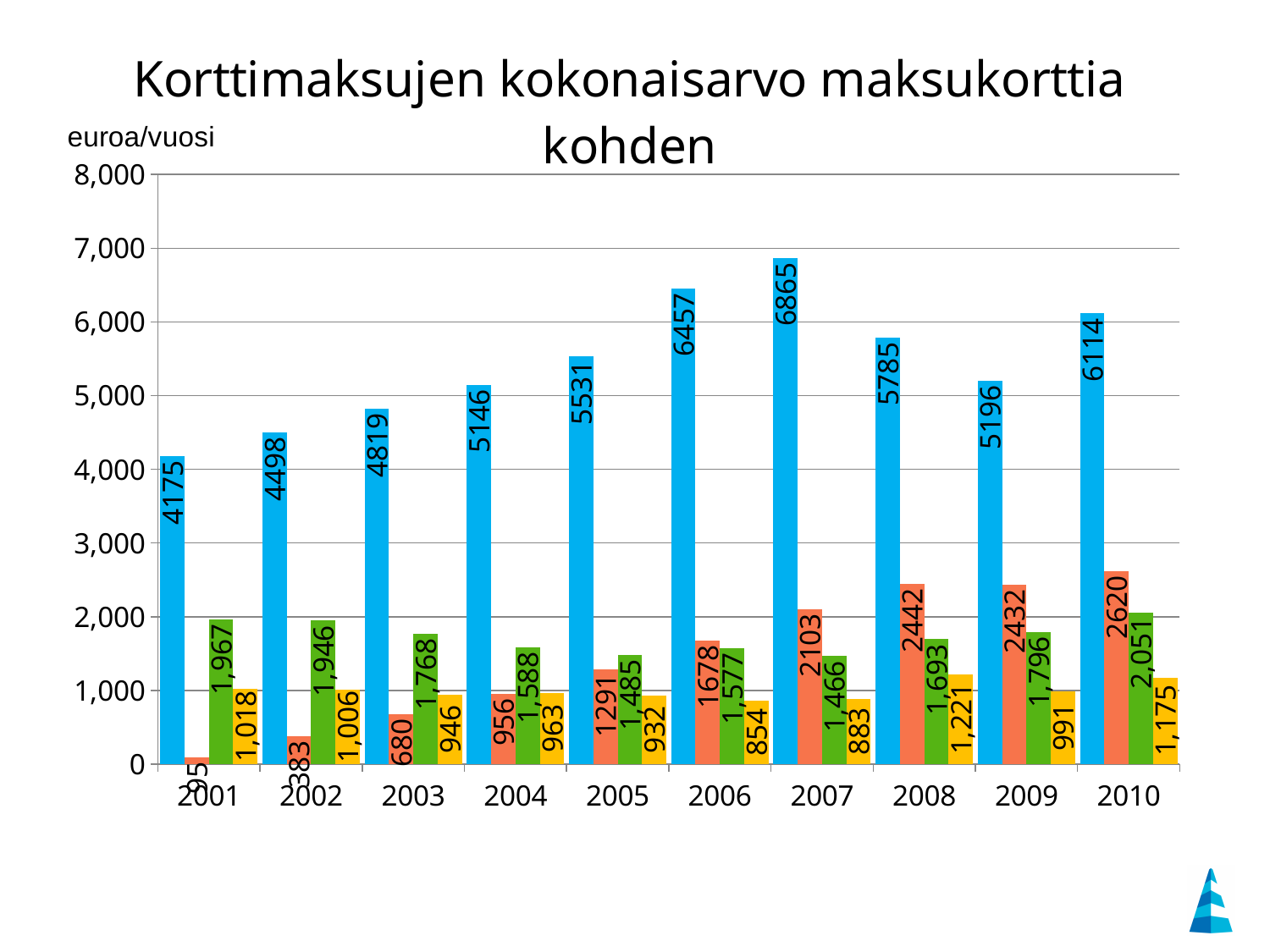
What unit label is shown above the y axis? euroa/vuosi What is the value of the yellow bar for 2008? 1,221 What kind of chart is shown on the slide? bar chart Which is larger in 2009, the orange bar or the green bar? the orange bar In which year is the blue bar highest? 2007 What is the value of the green bar for 2010? 2,051 Is the value of the blue bar for 2010 greater or less than 6,000? greater What is the difference between the blue bar values for 2007 and 2006? 408 How many years are shown on the x axis? 10 In which year is the yellow bar lowest? 2006 What is the value of the blue bar for 2007? 6865 What is the value of the orange bar for 2005? 1291